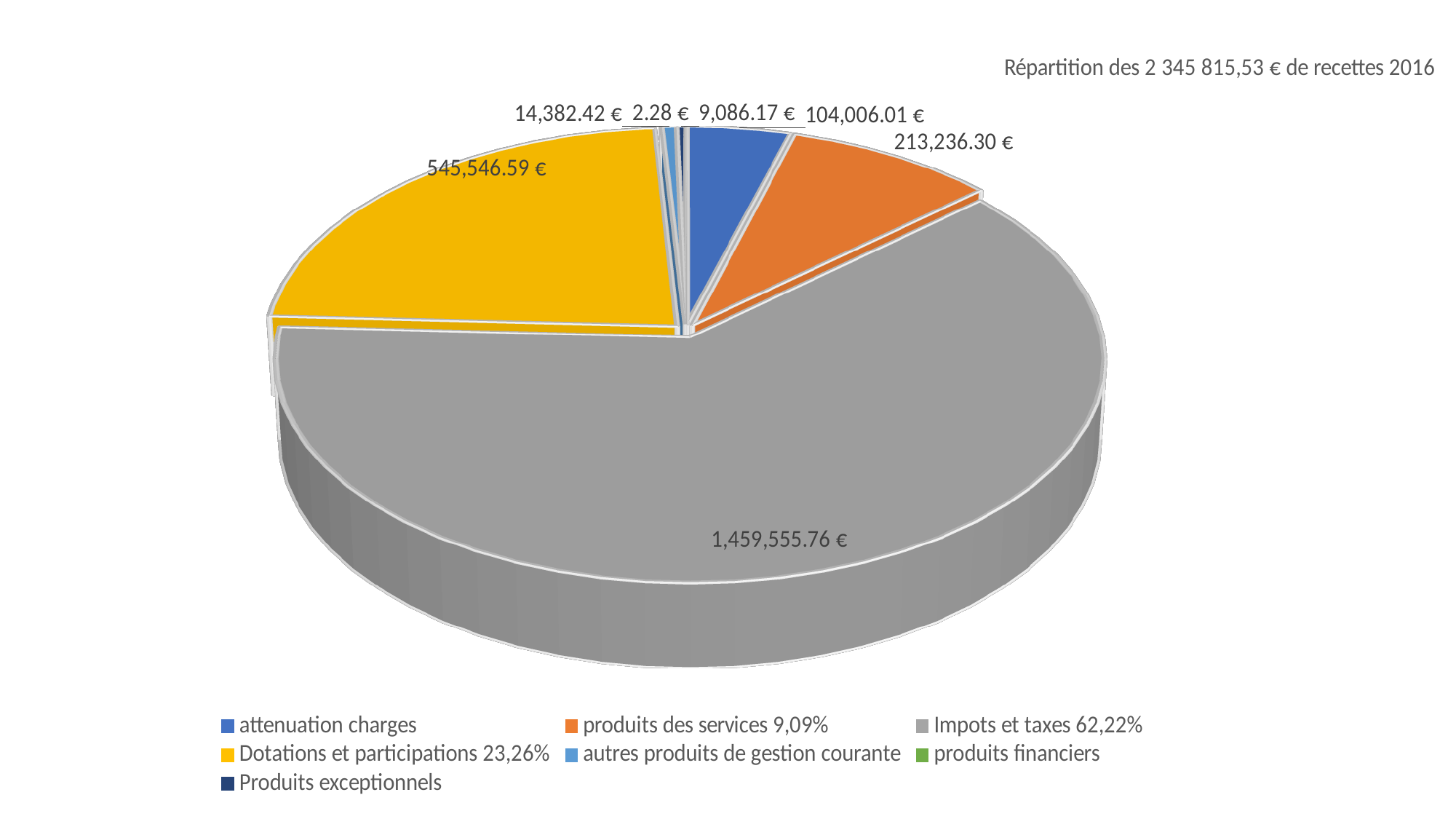
What is the value for Dotations et participations? 545,546.59 € What is the value for attenuation charges? 104,006.01 € What is the difference between the values for produits des services and attenuation charges? 109,230.29 € How many categories does the pie chart have? 7 Which is larger, the value for autres produits de gestion courante or the value for Produits exceptionnels? autres produits de gestion courante What is the value for produits des services? 213,236.30 € What is the value for Impots et taxes? 1,459,555.76 € Which category has the smallest slice of the pie? produits financiers Which category has the largest slice of the pie? Impots et taxes What share of the pie does Impots et taxes represent, according to the legend? 62,22% What kind of chart is shown on the slide? pie chart What is the value for produits financiers? 2.28 €